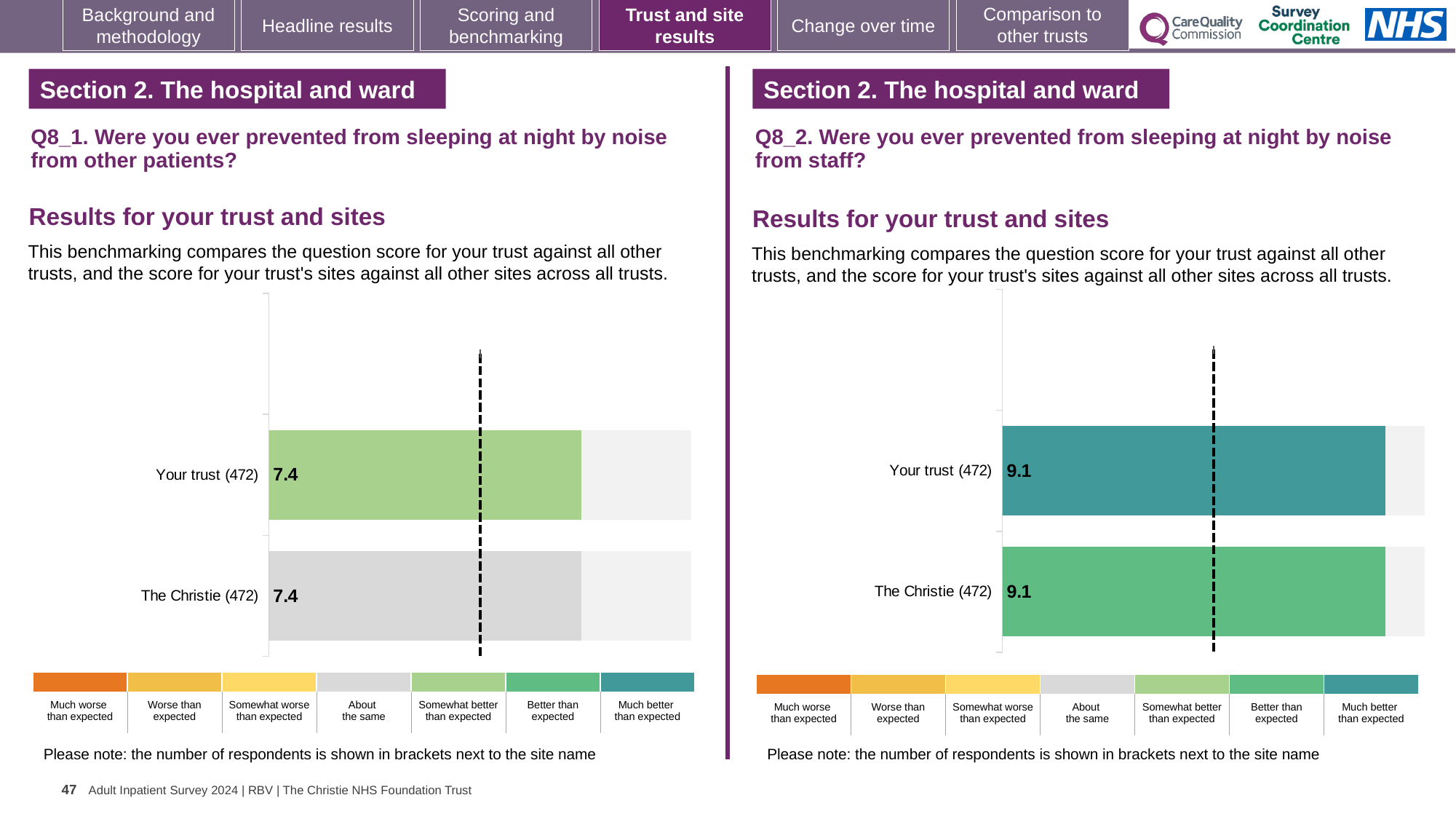
In the Q8_1 chart (left), what is the score for Your trust? 7.4 In the Q8_1 chart (left), how many respondents are shown in brackets next to Your trust? 472 In the Q8_1 chart (left), what is the difference between the score for Your trust and the score for The Christie? 0.0 In the Q8_2 chart (right), what is the difference between the score for Your trust and the score for The Christie? 0.0 In the Q8_1 chart (left), which benchmark category does the colour of The Christie bar correspond to? About the same How many bars are plotted in the Q8_1 chart (left)? 2 In the Q8_2 chart (right), what is the score for Your trust? 9.1 In the Q8_1 chart (left), what is the score for The Christie? 7.4 In the Q8_2 chart (right), which benchmark category does the colour of the Your trust bar correspond to? Much better than expected What kind of chart is used for the Q8_2 results (right)? Bar chart How many bars are plotted in the Q8_2 chart (right)? 2 In the Q8_2 chart (right), what is the score for The Christie? 9.1